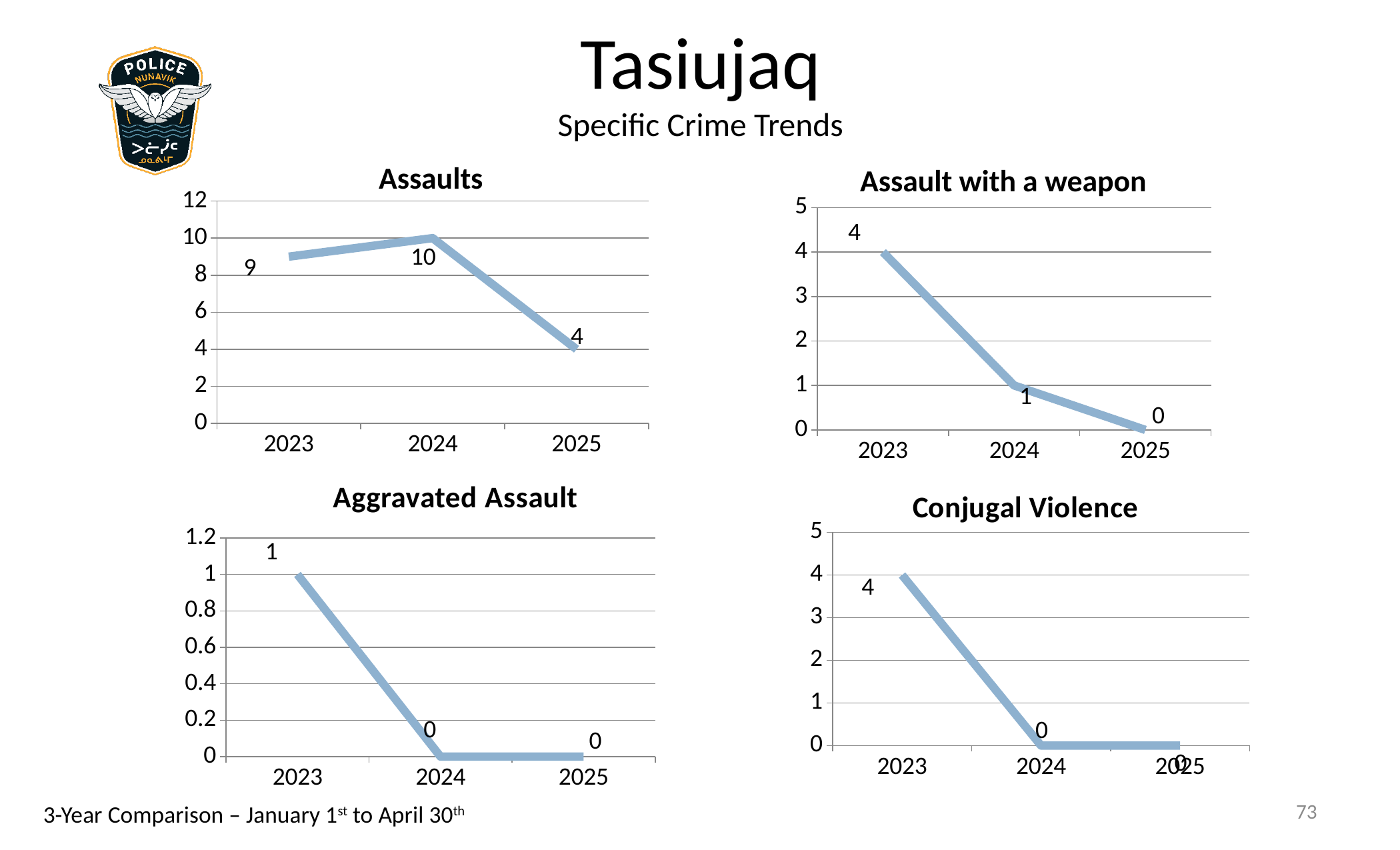
In the Conjugal Violence chart, what is the value for 2024? 0 In the Aggravated Assault chart, what is the value for 2023? 1 In the Assault with a weapon chart, do the values rise or fall from 2023 to 2025? fall In the Conjugal Violence chart, which is larger, the value for 2023 or the value for 2024? 2023 In the Assault with a weapon chart, what is the value for 2023? 4 In the Aggravated Assault chart, how many years are plotted on the x axis? 3 In the Assaults chart, which year has the lowest value? 2025 In the Assaults chart, what is the value for 2024? 10 What is the title of the chart in the bottom-left of the slide? Aggravated Assault What kind of chart is the Assaults chart? line chart In the Assaults chart, what is the difference between the 2024 and 2025 values? 6 In the Assault with a weapon chart, which year has the highest value? 2023